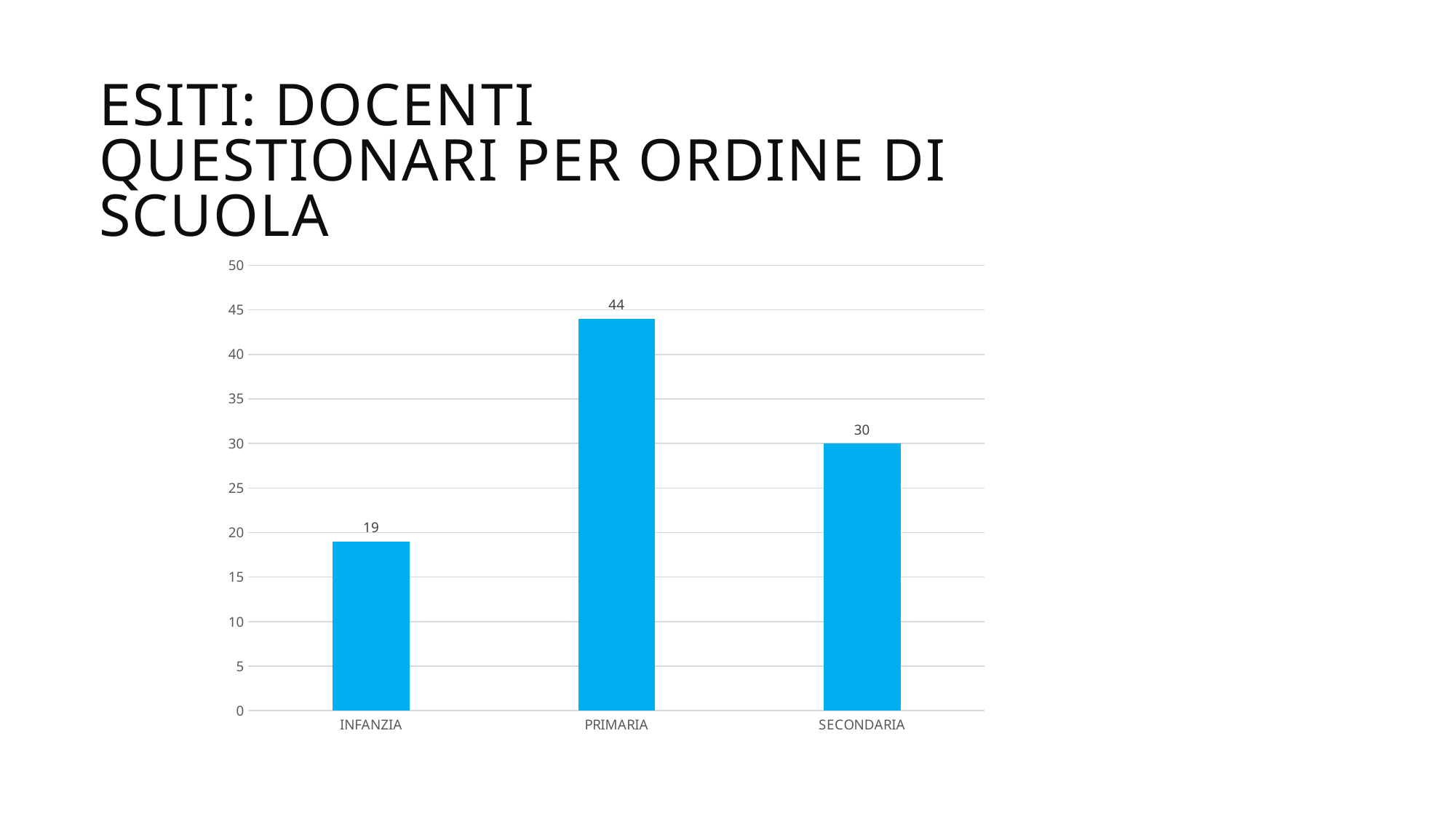
Which category has the highest value? PRIMARIA What is the value for INFANZIA? 19 What is the value for PRIMARIA? 44 How many categories are shown on the x axis? 3 Is the value for PRIMARIA greater or less than 40? greater What kind of chart is shown on the slide? bar chart What is the difference between the values for SECONDARIA and INFANZIA? 11 Which is larger, the value for INFANZIA or the value for SECONDARIA? SECONDARIA What is the difference between the values for PRIMARIA and SECONDARIA? 14 What is the total of the three values shown in the chart? 93 Which category has the lowest value? INFANZIA What is the value for SECONDARIA? 30